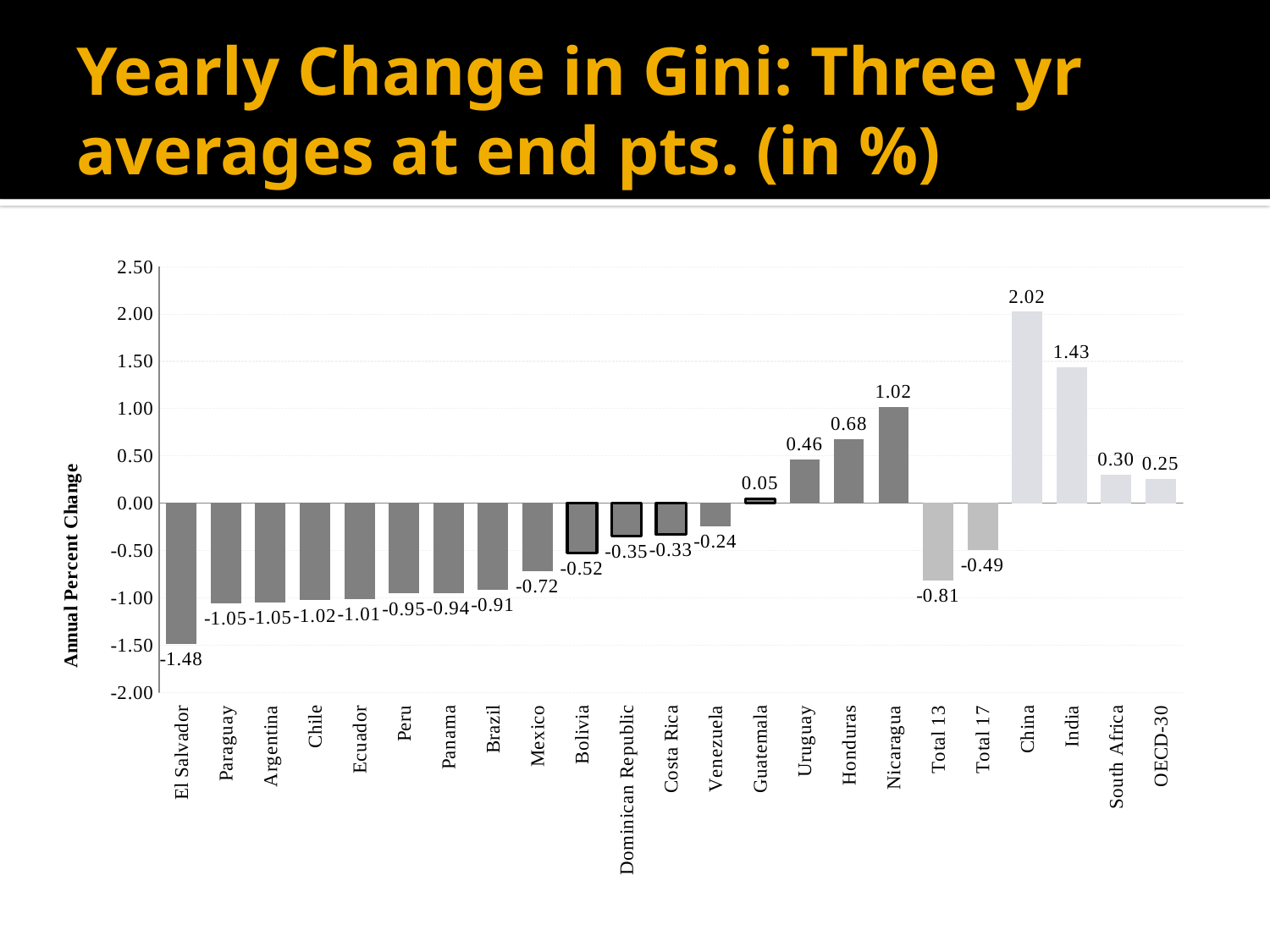
What is the value for Total 13? -0.81 What is the value for Guatemala? 0.05 How many categories are shown on the x axis? 23 Which category has the highest value? China What is the difference between the values for China and India? 0.59 Do the values rise or fall along the x axis from El Salvador to Nicaragua? Rise Which category has the lowest value? El Salvador What is the value for China? 2.02 Which is larger, the value for Nicaragua or the value for Honduras? Nicaragua What is the label on the y axis? Annual Percent Change What kind of chart is this? Bar chart What is the value for El Salvador? -1.48